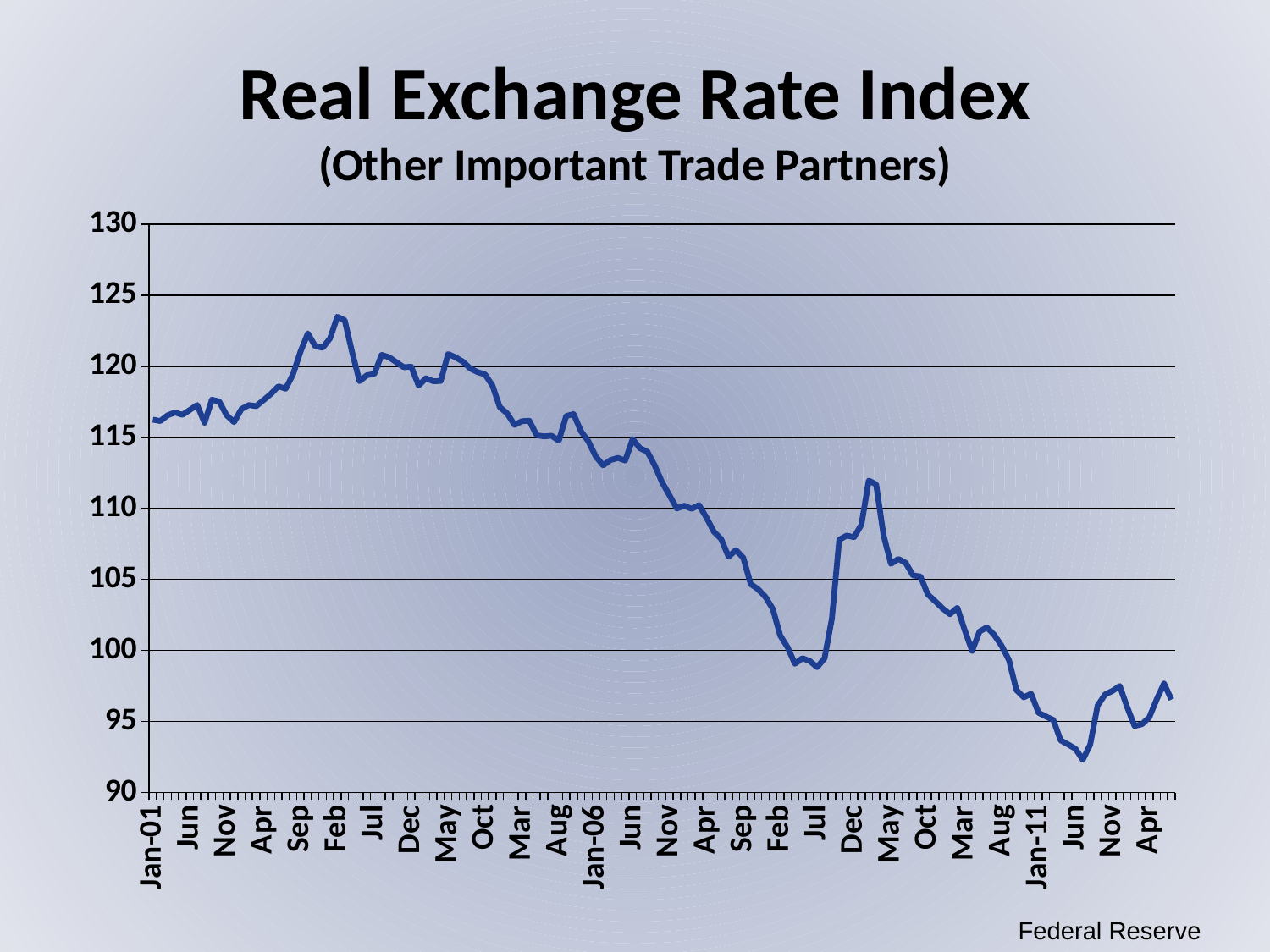
What are the lowest and highest values labelled on the vertical axis? 90 and 130 What kind of chart is shown on the slide? line chart Is the value of the index at Jan-06 greater or less than 115? less Overall, does the Real Exchange Rate Index rise or fall from Jan-01 to the end of the series? fall What source is credited at the bottom of the slide? Federal Reserve Does the lowest point of the line occur in the first half or the second half of the period shown? second half Is the lowest point of the line greater or less than 95? less Is the value of the index at Jan-11 greater or less than 100? less Which is larger, the index value at Jan-06 or at Jan-11? Jan-06 Which is larger, the index value at Jan-01 or at Jan-11? Jan-01